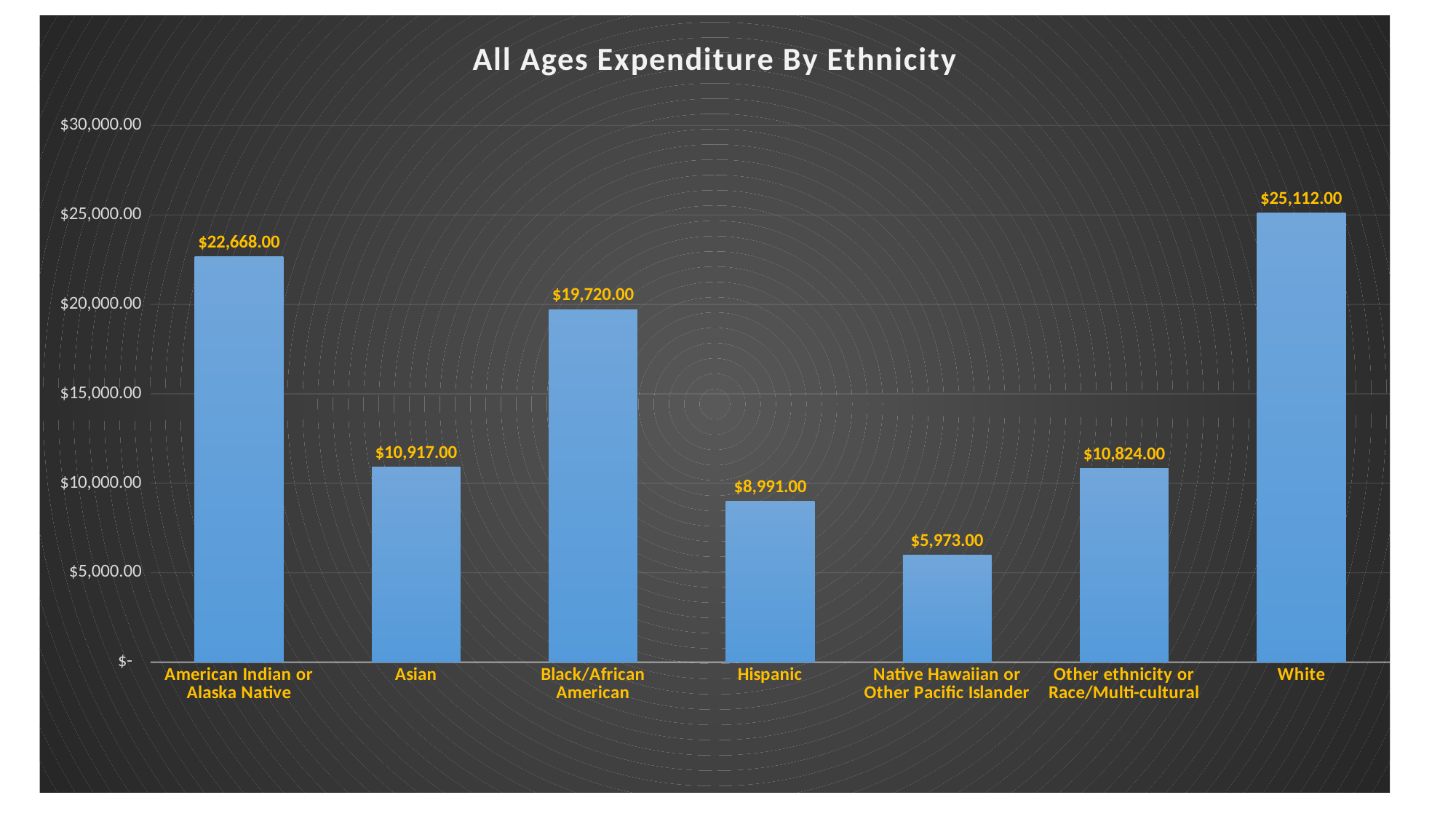
What is the difference between the expenditure for White and for American Indian or Alaska Native? $2,444.00 Which ethnicity has the highest expenditure? White What is the expenditure value for Native Hawaiian or Other Pacific Islander? $5,973.00 Which ethnicity has the lowest expenditure? Native Hawaiian or Other Pacific Islander What is the expenditure value for Hispanic? $8,991.00 What kind of chart is shown on the slide? bar chart Is the expenditure for Black/African American greater or less than $20,000.00? less How many ethnicity categories are shown in the chart? 7 What is the difference between the expenditure for Asian and for Other ethnicity or Race/Multi-cultural? $93.00 What is the title of the chart? All Ages Expenditure By Ethnicity What is the expenditure value for Asian? $10,917.00 Which is larger, the expenditure for Black/African American or for American Indian or Alaska Native? American Indian or Alaska Native